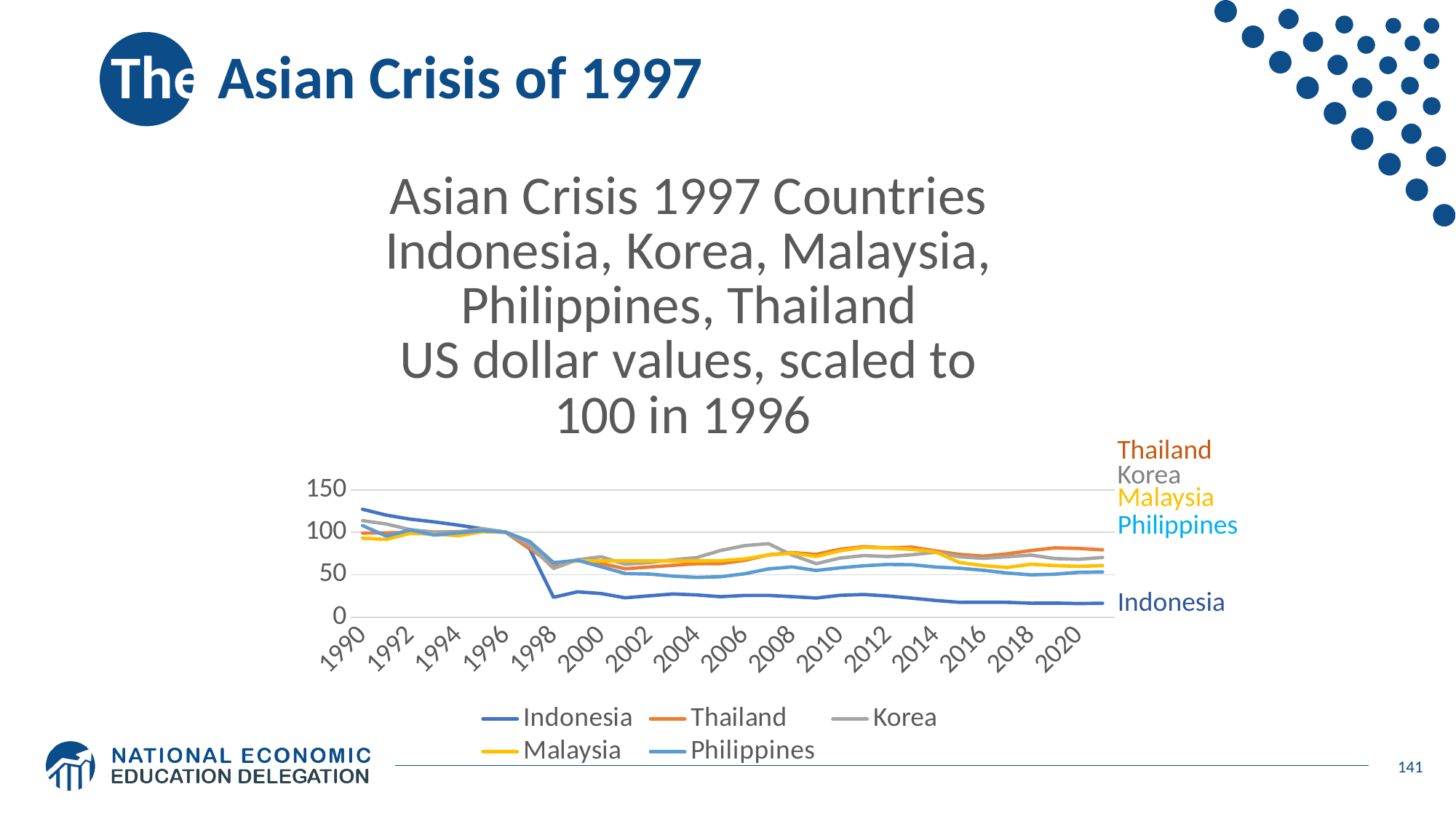
In 2020, which is larger: the value for Thailand or the value for Indonesia? Thailand Is the value for Indonesia in 2020 greater or less than 50? less How many series does the legend list? 5 Does the value for Indonesia rise or fall from 1990 to 2020? fall Is the value for Indonesia in 1990 greater or less than 100? greater Which country has the highest value in 1990? Indonesia Which country has the lowest value in 2020? Indonesia Which countries are listed in the chart legend? Indonesia, Thailand, Korea, Malaysia, Philippines Is the value for Korea in 2008 greater or less than 50? greater What kind of chart is shown on the slide? line chart What is the value for Indonesia in 1996? 100